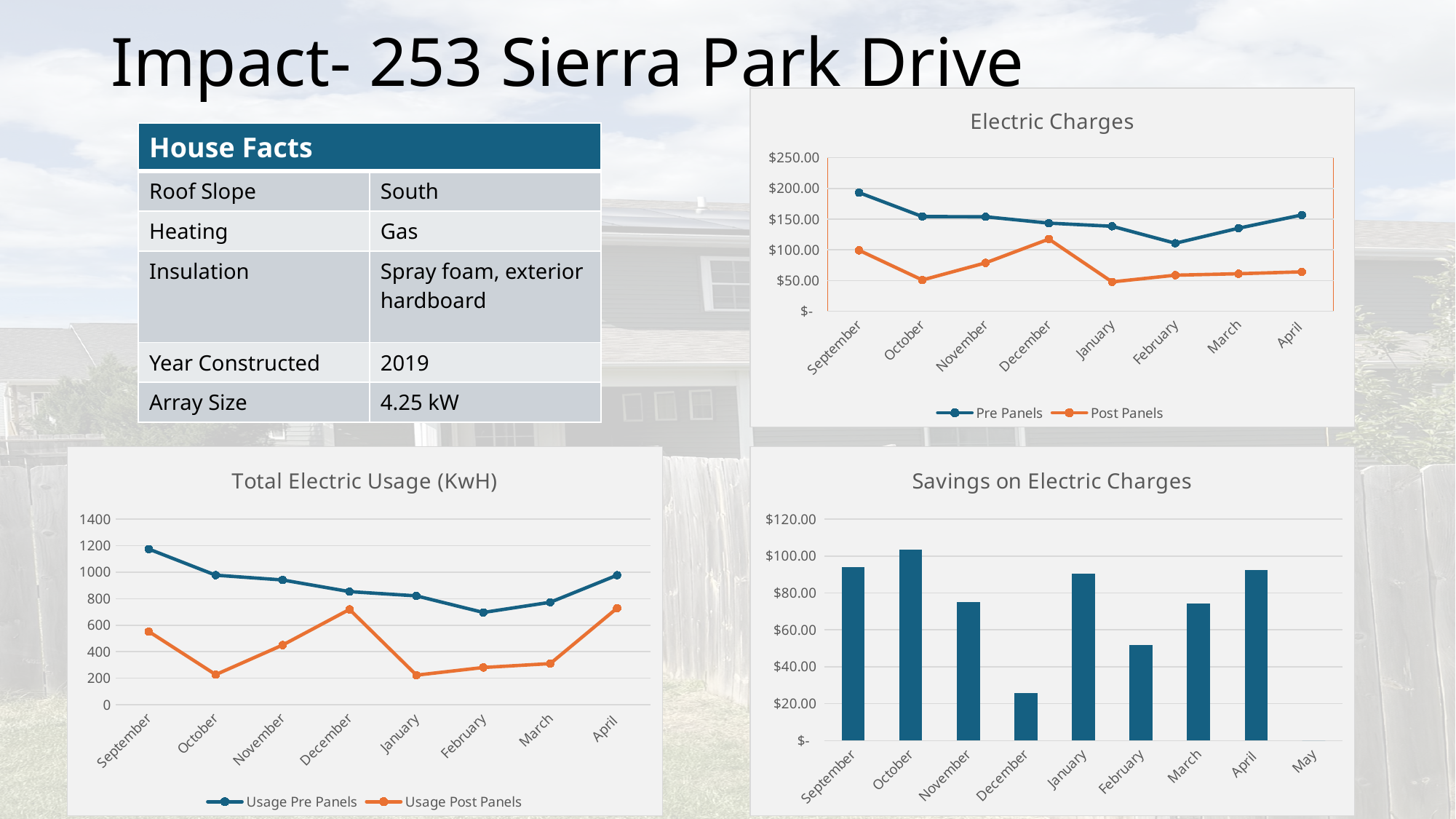
In the "Total Electric Usage (KwH)" chart, is the Usage Post Panels value for October greater or less than 400? less What kind of chart is the "Electric Charges" chart? line chart What kind of chart is the "Savings on Electric Charges" chart? bar chart In the "Savings on Electric Charges" chart, is the value for October greater or less than $100.00? greater In the "Electric Charges" chart, how many series does the legend list? 2 In the "Electric Charges" chart, which month has the lowest Post Panels value? January In the "Electric Charges" chart, which month has the highest Pre Panels value? September In the "Total Electric Usage (KwH)" chart, which is larger in December: Usage Pre Panels or Usage Post Panels? Usage Pre Panels In the "Savings on Electric Charges" chart, which month has the lowest visible bar? December In the "Savings on Electric Charges" chart, which month has the highest savings? October In the "Total Electric Usage (KwH)" chart, which month has the lowest Usage Pre Panels value? February In the "Electric Charges" chart, is the Pre Panels value for September greater or less than $150.00? greater